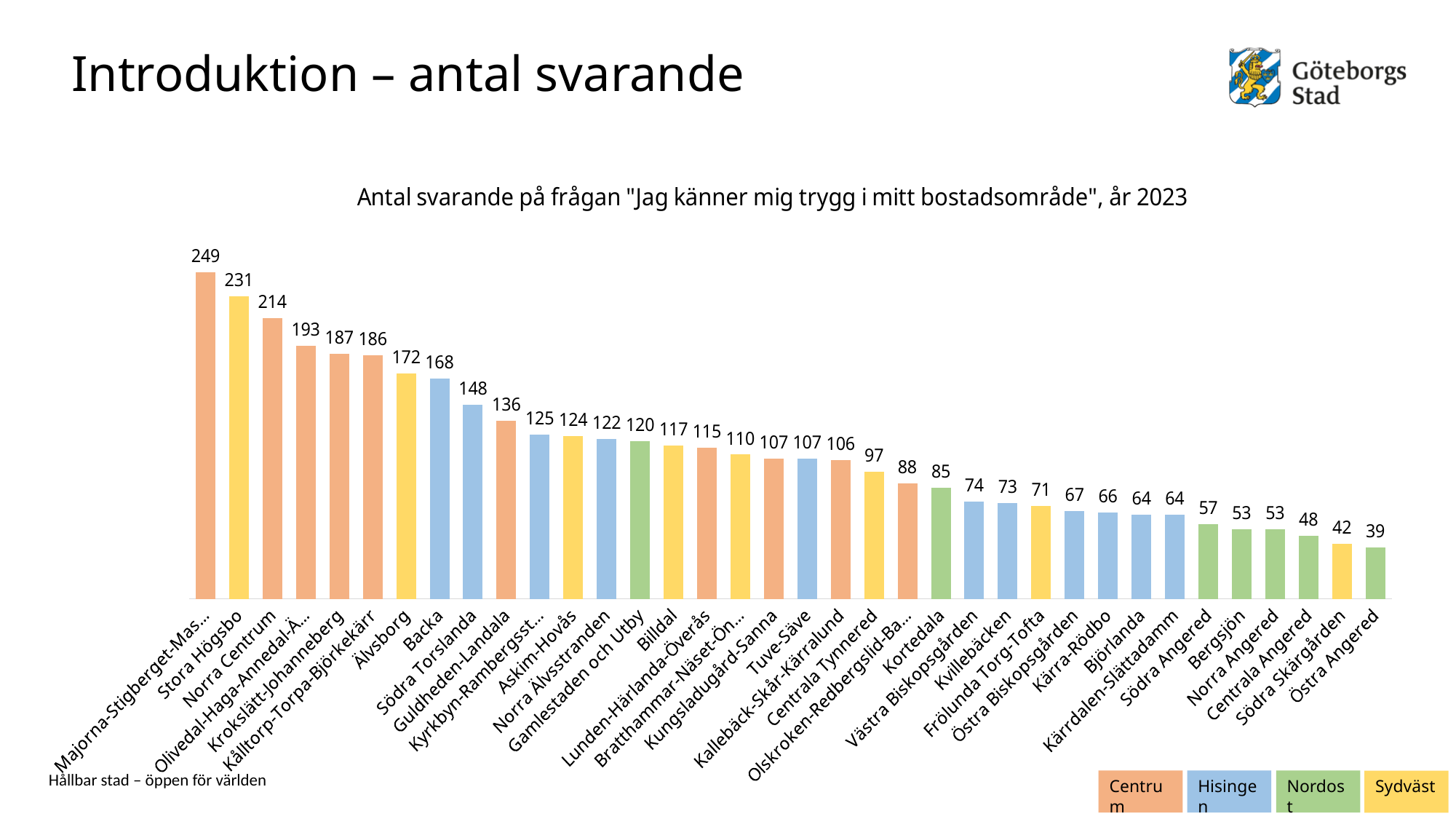
Which area has the lowest number of respondents? Östra Angered How many entries does the legend list? 4 Which area has the highest number of respondents? Majorna-Stigberget-Mas... What type of chart is shown on the slide? Bar chart How many areas (bars) are shown in the chart? 36 What is the difference between the values for Södra Torslanda and Guldheden-Landala? 12 Do the values rise or fall from left to right along the x axis? Fall Which has a larger value, Älvsborg or Billdal? Älvsborg What is the difference between the values for Stora Högsbo and Norra Centrum? 17 What is the value for Kortedala? 85 What is the value for Frölunda Torg-Tofta? 71 How many respondents are shown for Backa? 168